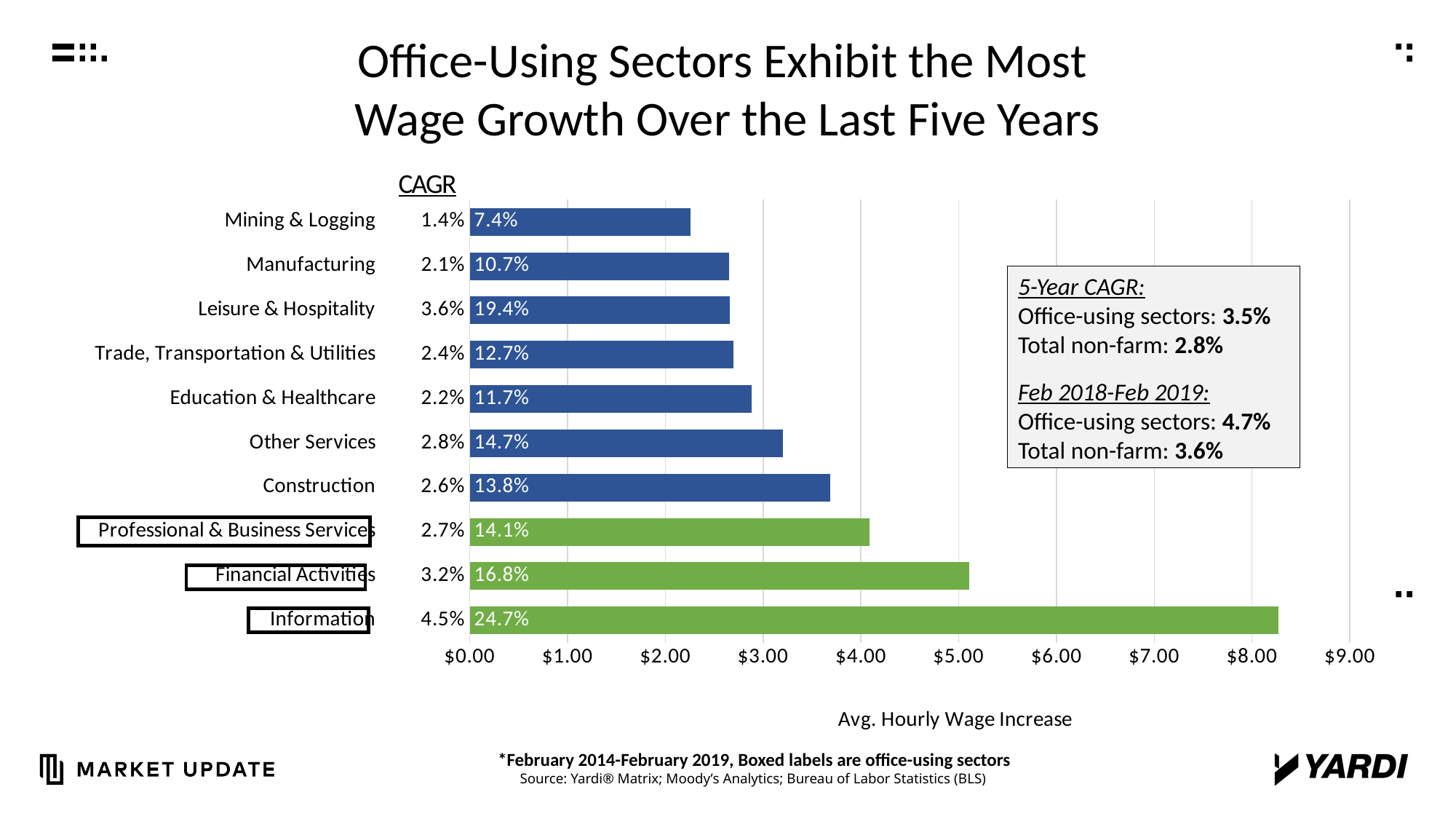
How many sectors are shown with green bars (office-using sectors)? 3 Is the average hourly wage increase for Information greater or less than $8.00? greater Which has the larger percentage label on its bar, Leisure & Hospitality or Financial Activities? Leisure & Hospitality Is the average hourly wage increase for Mining & Logging greater or less than $3.00? less What kind of chart is shown on the slide? bar chart What is the CAGR shown for Information? 4.5% What is the difference between the percentage labels for Information (24.7%) and Mining & Logging (7.4%)? 17.3 percentage points Which sector has the shortest bar for average hourly wage increase? Mining & Logging Which sector has the longest bar for average hourly wage increase? Information What percentage label is printed on the bar for Mining & Logging? 7.4% What percentage label is printed on the bar for Financial Activities? 16.8% How many sectors are plotted in the chart? 10